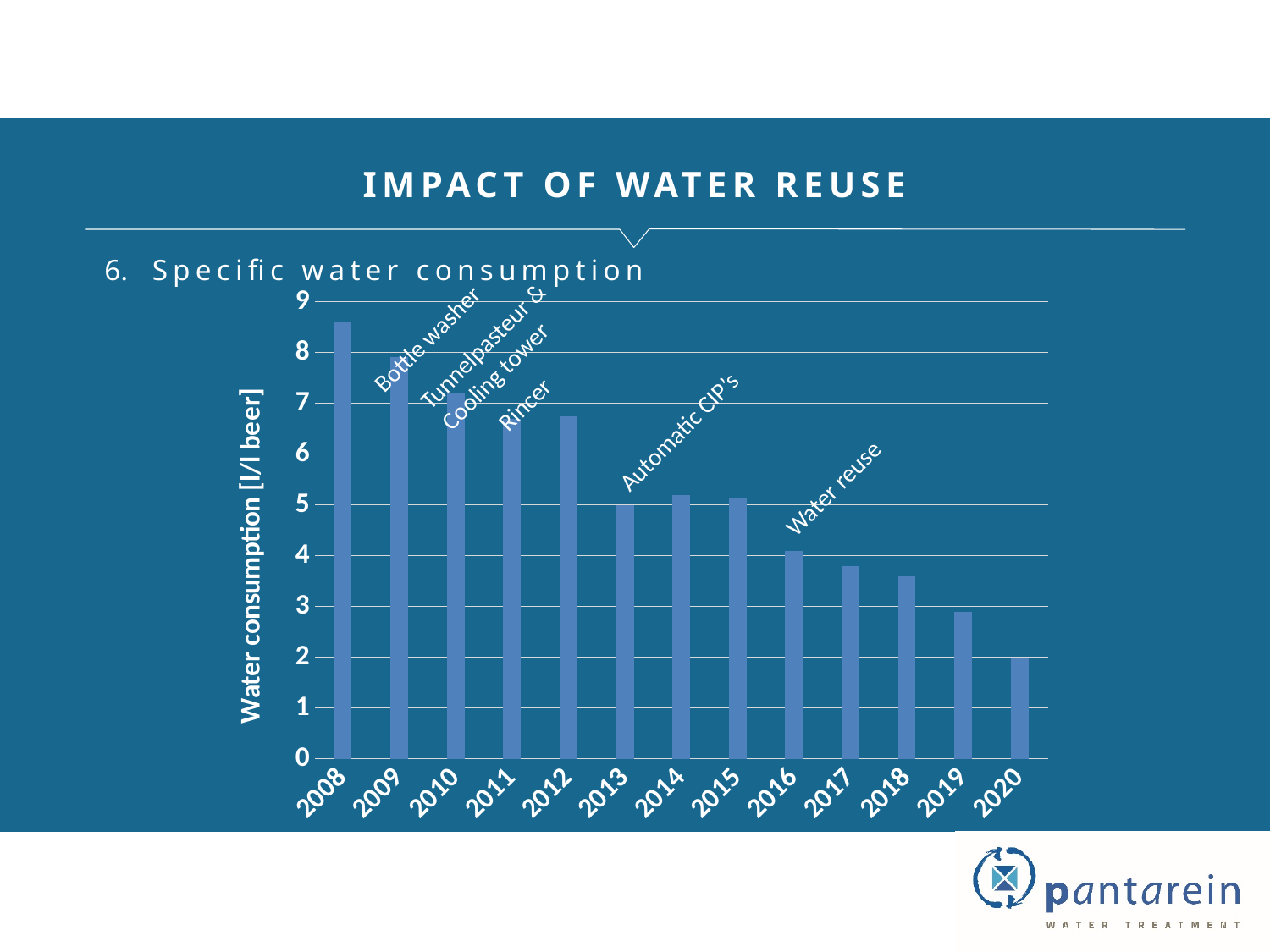
Is the value for 2019 greater or less than 3? less Is the value for 2017 greater or less than 4? less What kind of chart is shown on the slide? bar chart Do the water consumption values generally rise or fall from 2008 to 2020? fall Which year has the lowest water consumption? 2020 What is the title of the slide? IMPACT OF WATER REUSE Which year has the highest water consumption? 2008 What is the title of the vertical axis of the chart? Water consumption [l/l beer] How many years are shown on the x axis of the chart? 13 Which year has the larger water consumption, 2009 or 2016? 2009 Is the value for 2008 greater or less than 8? greater